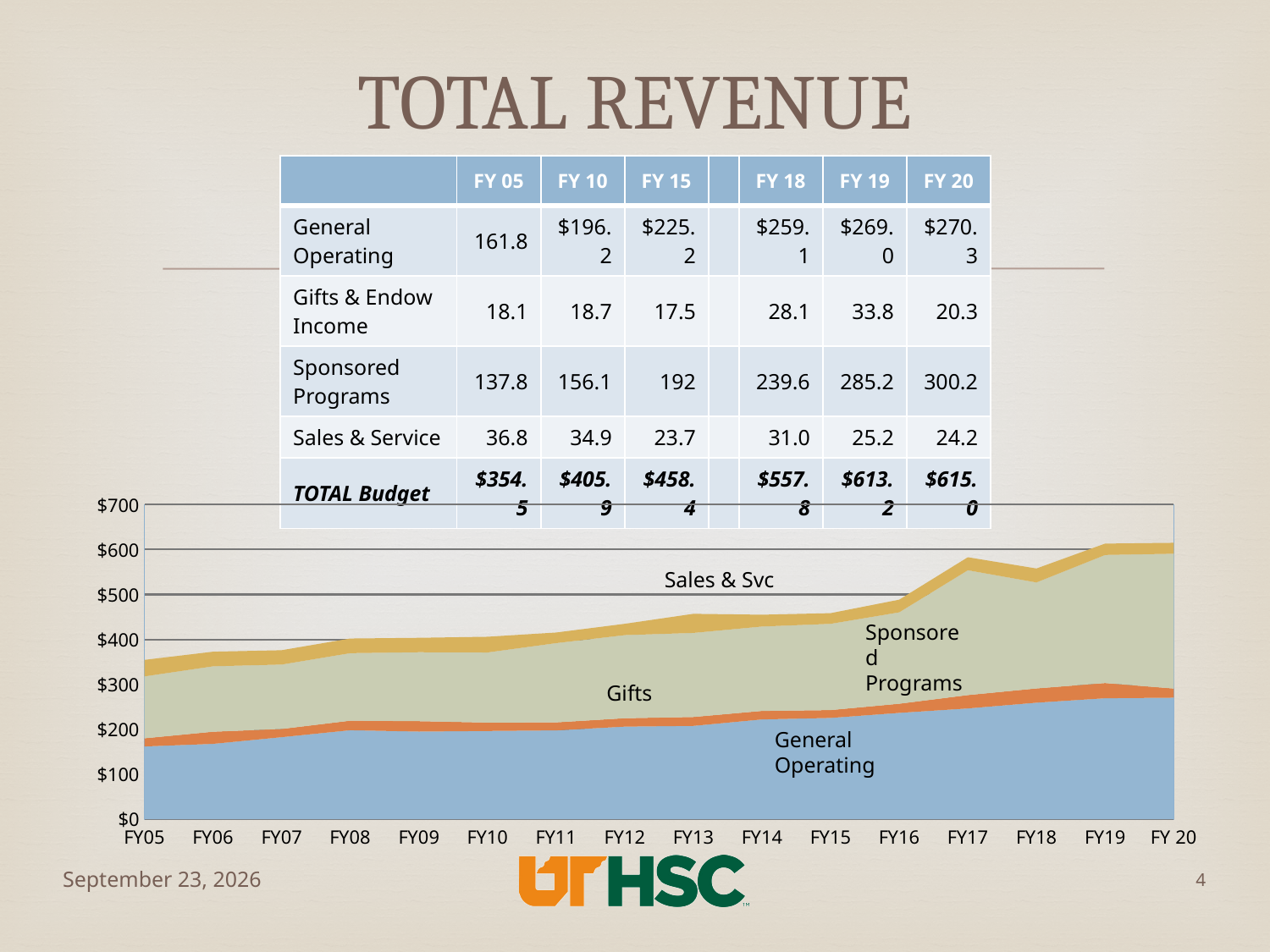
Is the total revenue at FY17 in the area chart greater or less than $600? less What kind of chart is shown at the bottom of the slide? Stacked area chart Is the total revenue at FY20 in the area chart greater or less than $600? greater According to the table, what is the TOTAL Budget for FY 19? $613.2 Does the total revenue in the area chart generally rise or fall from FY05 to FY20? Rise According to the table, which fiscal year has the highest TOTAL Budget? FY 20 According to the table, by how much did Sponsored Programs increase from FY 05 to FY 20? 162.4 How many fiscal years are plotted along the x axis of the area chart? 16 How many revenue categories are stacked in the area chart? 4 According to the table, what is the Sponsored Programs value for FY 20? 300.2 Is the total revenue at FY05 in the area chart greater or less than $400? less Which revenue category forms the bottom (blue) layer of the area chart? General Operating